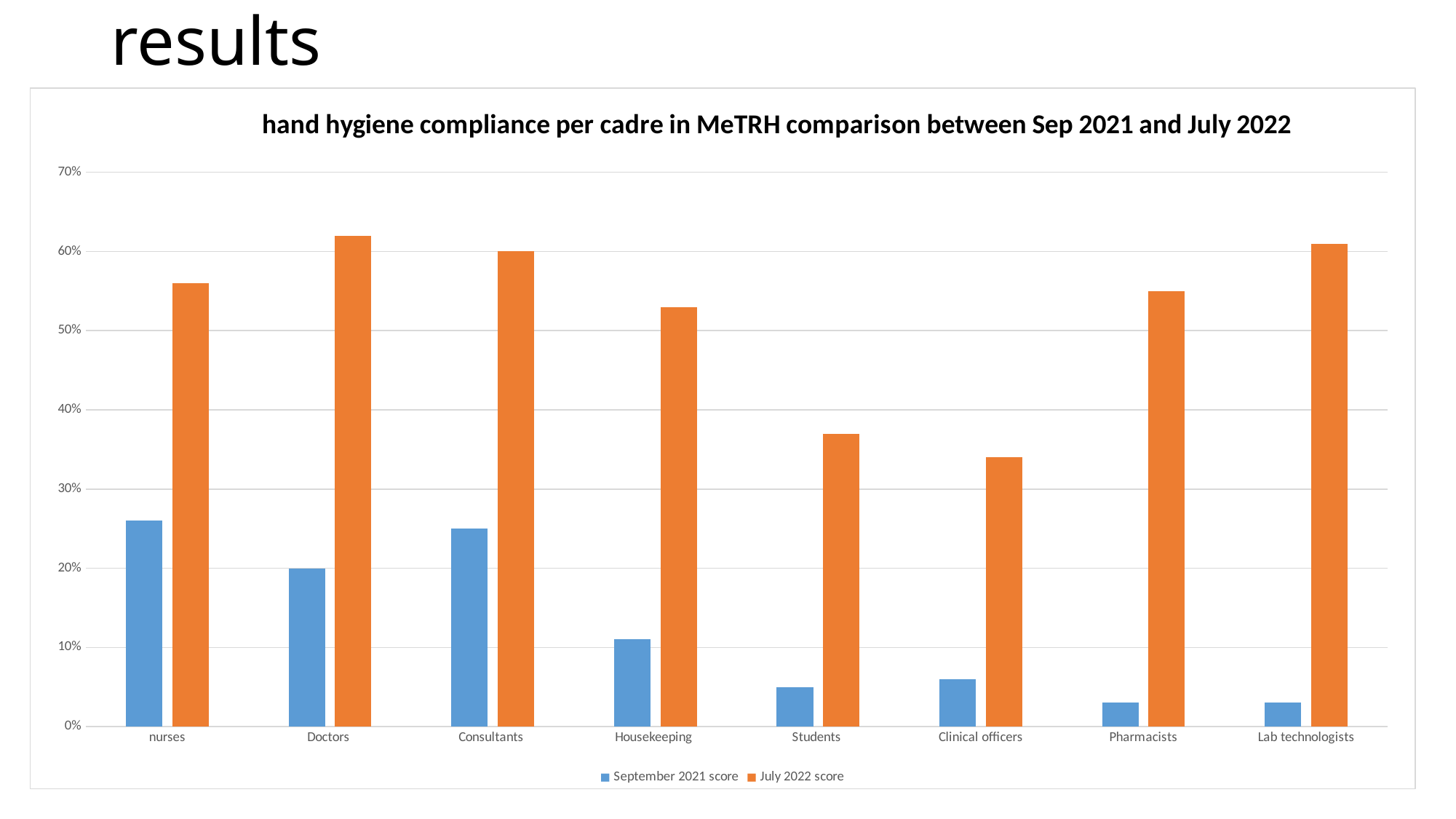
Is the September 2021 score for Housekeeping greater or less than 20%? less Is the July 2022 score for Pharmacists greater or less than 50%? greater Which series is shown in orange in the chart? July 2022 score How many series does the chart legend list? 2 Which has the higher July 2022 score, Housekeeping or Students? Housekeeping Is the September 2021 score for Clinical officers greater or less than 10%? less What is the September 2021 score for Doctors? 20% How many cadres (categories) are shown on the x axis of the chart? 8 Which has the higher September 2021 score, nurses or Doctors? nurses What kind of chart is shown on the slide? bar chart